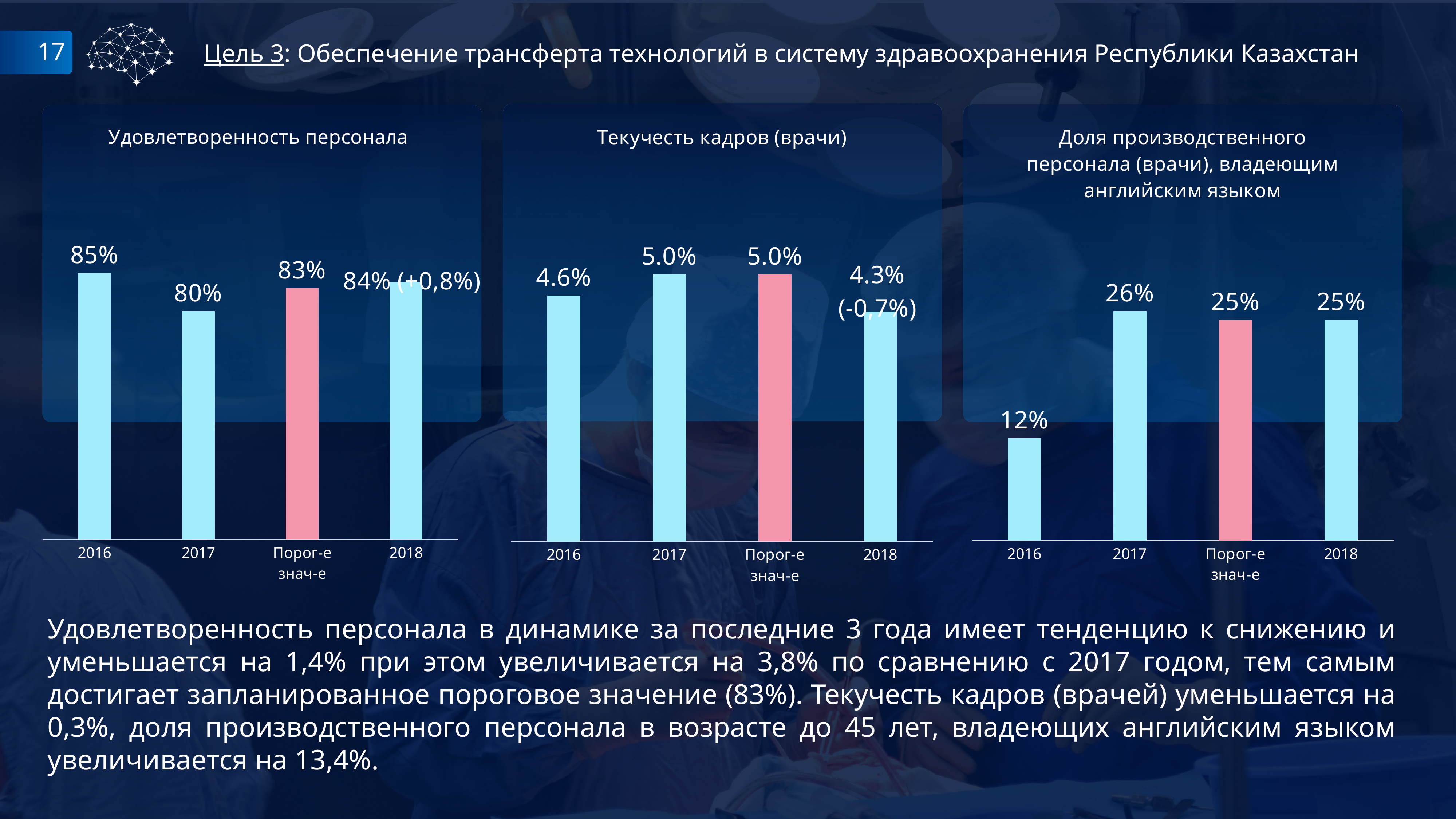
In the chart titled "Текучесть кадров (врачи)", which category has the lowest value? 2018 In the chart titled "Удовлетворенность персонала", what is the value for Порог-е знач-е? 83% In the chart on the right about the share of doctors who speak English, which category has the highest value? 2017 In the chart titled "Текучесть кадров (врачи)", which is larger, the value for 2016 or the value for 2017? 2017 In the chart titled "Удовлетворенность персонала", what is the difference between the 2016 and 2017 values? 5% In the chart titled "Текучесть кадров (врачи)", what is the value for 2016? 4.6% How many bars are in the chart titled "Удовлетворенность персонала"? 4 In the chart titled "Удовлетворенность персонала", which category has the lowest value? 2017 In the chart on the right about the share of doctors who speak English, what is the difference between the 2017 and 2016 values? 14% In the chart on the right about the share of doctors who speak English, what is the value for 2016? 12% In the chart titled "Текучесть кадров (врачи)", what is the value for 2018? 4.3% In the chart titled "Удовлетворенность персонала", what is the value for 2016? 85%